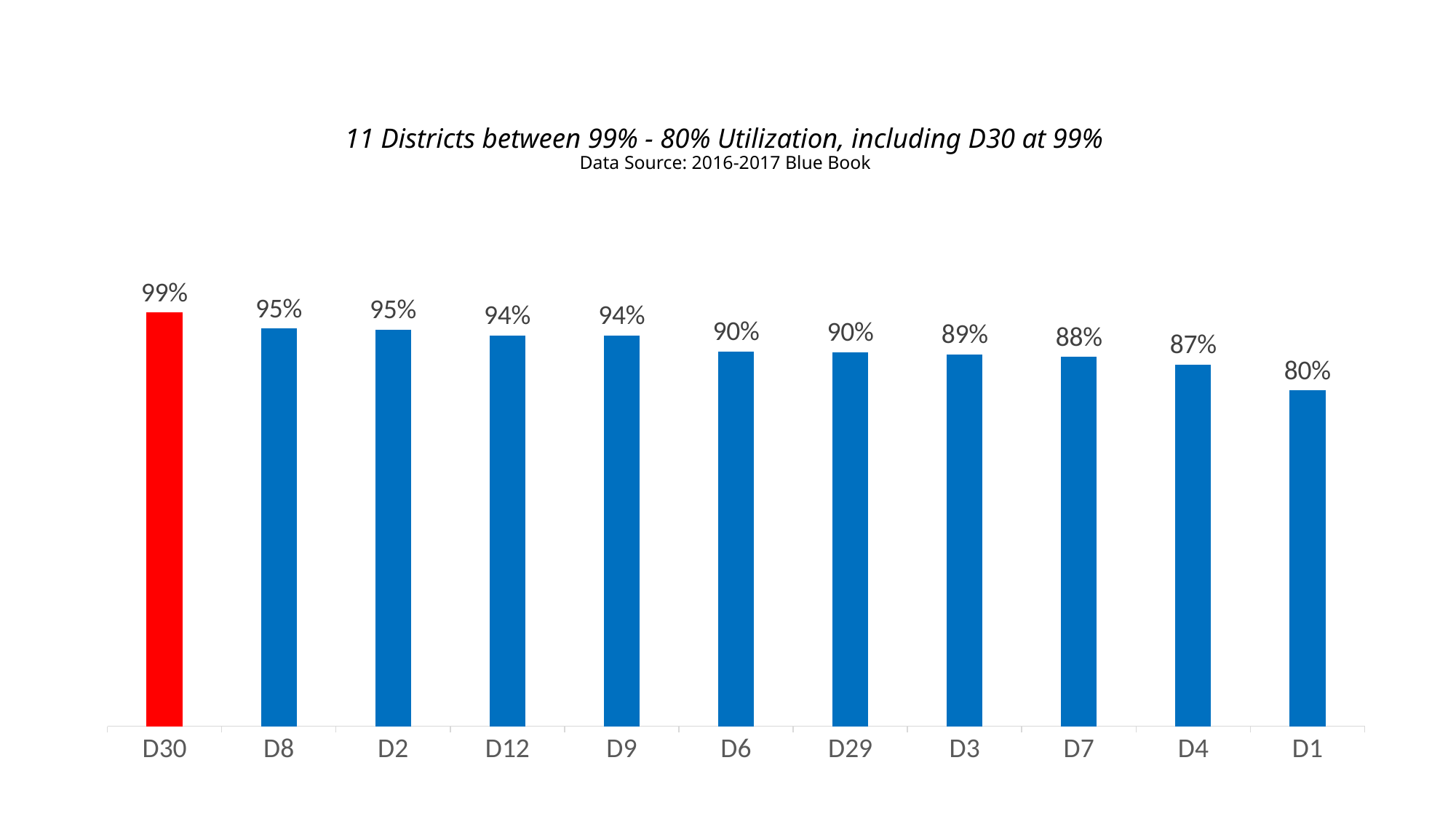
Do the values rise or fall from left to right along the x axis? Fall What is the difference between the utilization of D30 and D1? 19% Which has a higher utilization, D2 or D7? D2 Which bar is coloured red? D30 Which district has the lowest utilization? D1 What kind of chart is shown on the slide? Bar chart What is the utilization value for D4? 87% What is the difference between the utilization of D8 and D6? 5% How many districts are shown in the chart? 11 What is the utilization value for D30? 99% Which district has the highest utilization? D30 What is the utilization value for D12? 94%